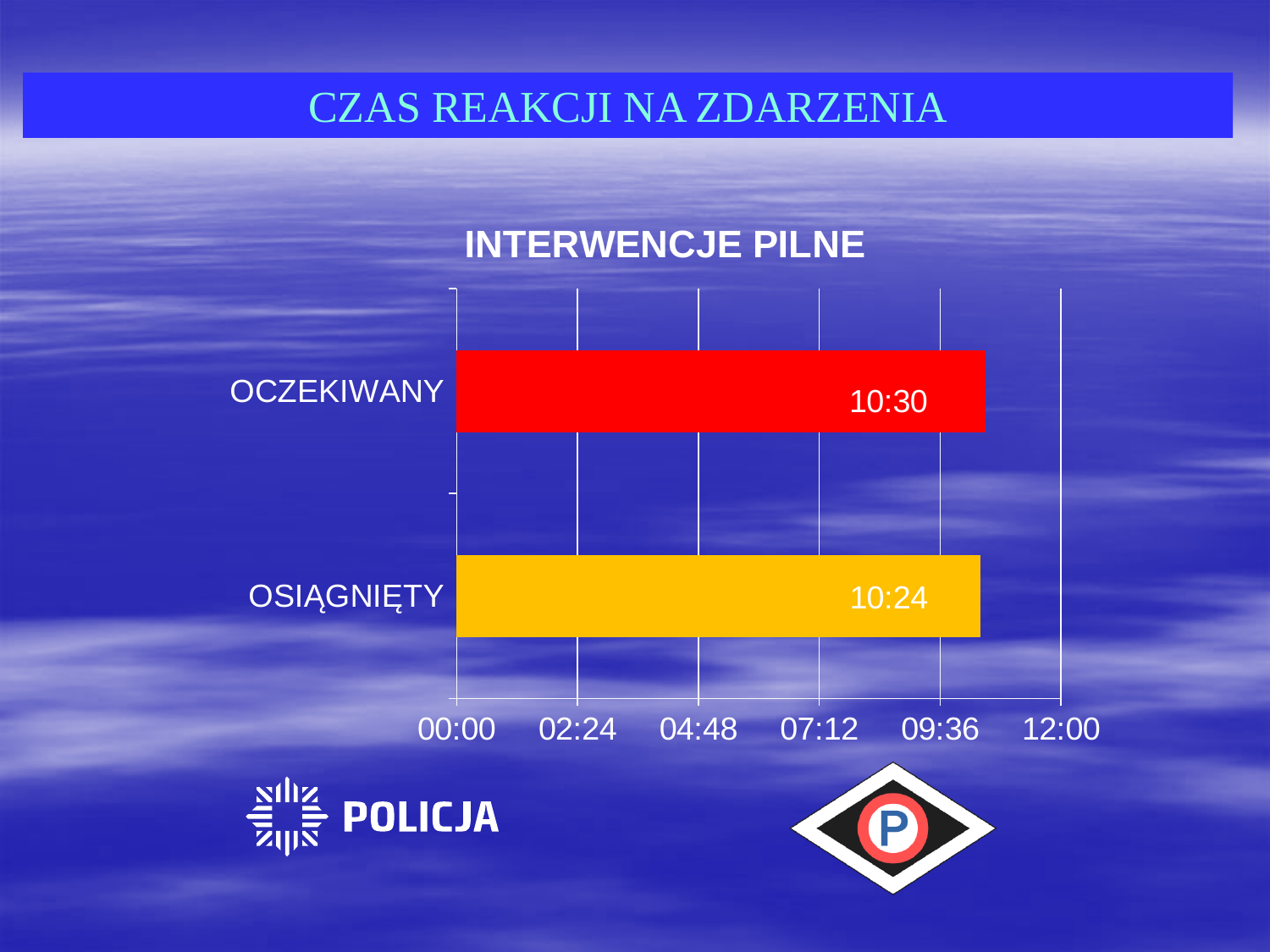
What type of chart is shown on the slide? bar chart Is the value for OSIĄGNIĘTY greater or less than 09:36? greater What is the title of the chart on the slide? INTERWENCJE PILNE Is the value for OCZEKIWANY larger or smaller than the value for OSIĄGNIĘTY? larger Is the value for OCZEKIWANY greater or less than 12:00? less What is the value shown for OCZEKIWANY in the INTERWENCJE PILNE chart? 10:30 By how much does the OCZEKIWANY value exceed the OSIĄGNIĘTY value? 00:06 Which category has the lower value in the INTERWENCJE PILNE chart? OSIĄGNIĘTY How many categories are plotted in the INTERWENCJE PILNE chart? 2 What is the value shown for OSIĄGNIĘTY in the INTERWENCJE PILNE chart? 10:24 What colour is the bar for OCZEKIWANY? red Which category has the higher value in the INTERWENCJE PILNE chart? OCZEKIWANY